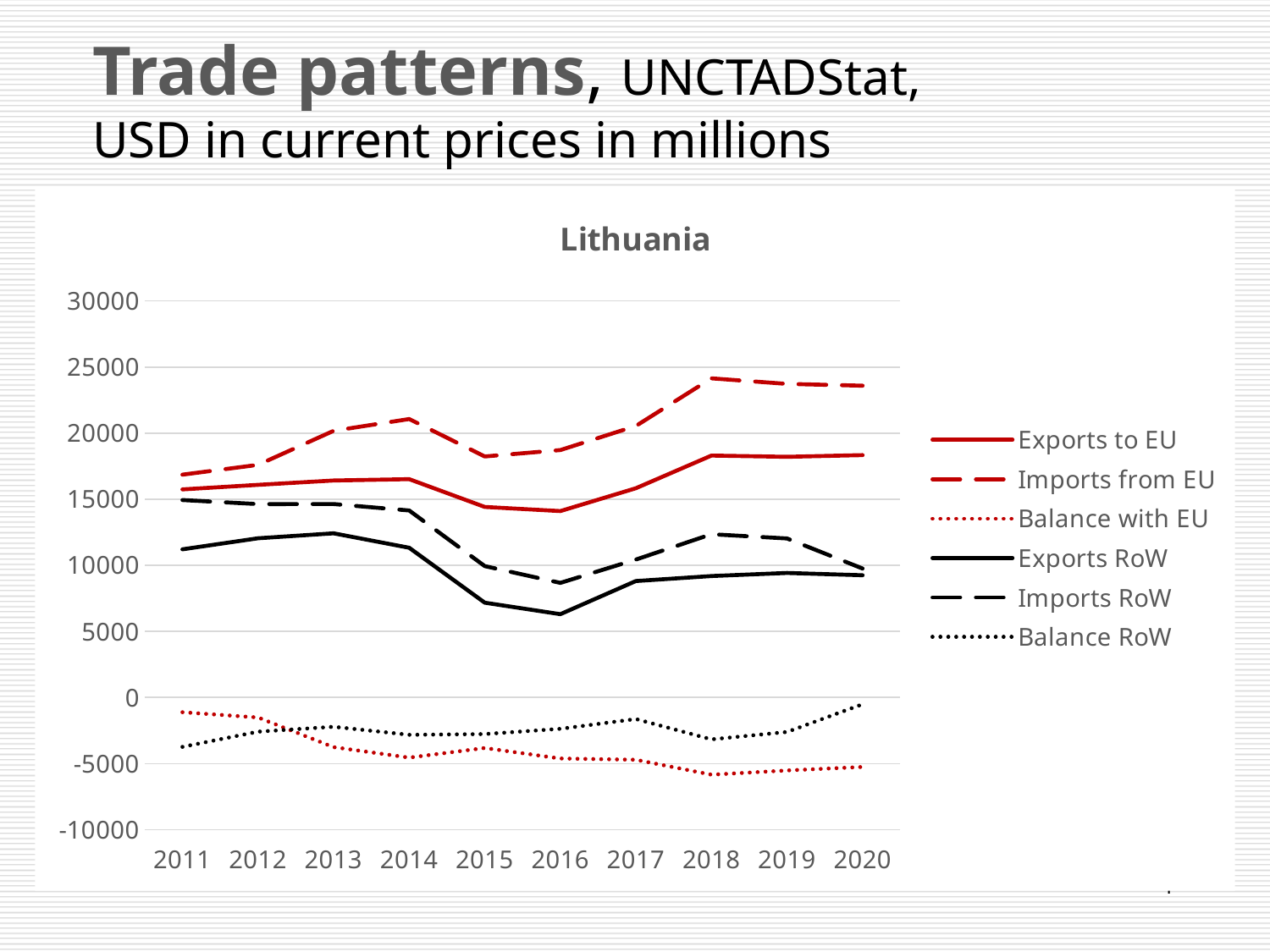
In which year is Imports from EU at its highest? 2018 What kind of chart is shown on the slide? line chart How many years are plotted along the x axis? 10 Is the value for Imports from EU in 2018 greater or less than 20000? greater How many series does the legend list? 6 In which year is Exports RoW at its lowest? 2016 Is the value for Exports to EU in 2020 greater or less than 15000? greater What is the title of the chart? Lithuania Is the value for Balance with EU in 2018 greater or less than -5000? less In 2020, which is larger: Imports from EU or Exports to EU? Imports from EU Does Exports to EU rise or fall between 2016 and 2018? rise